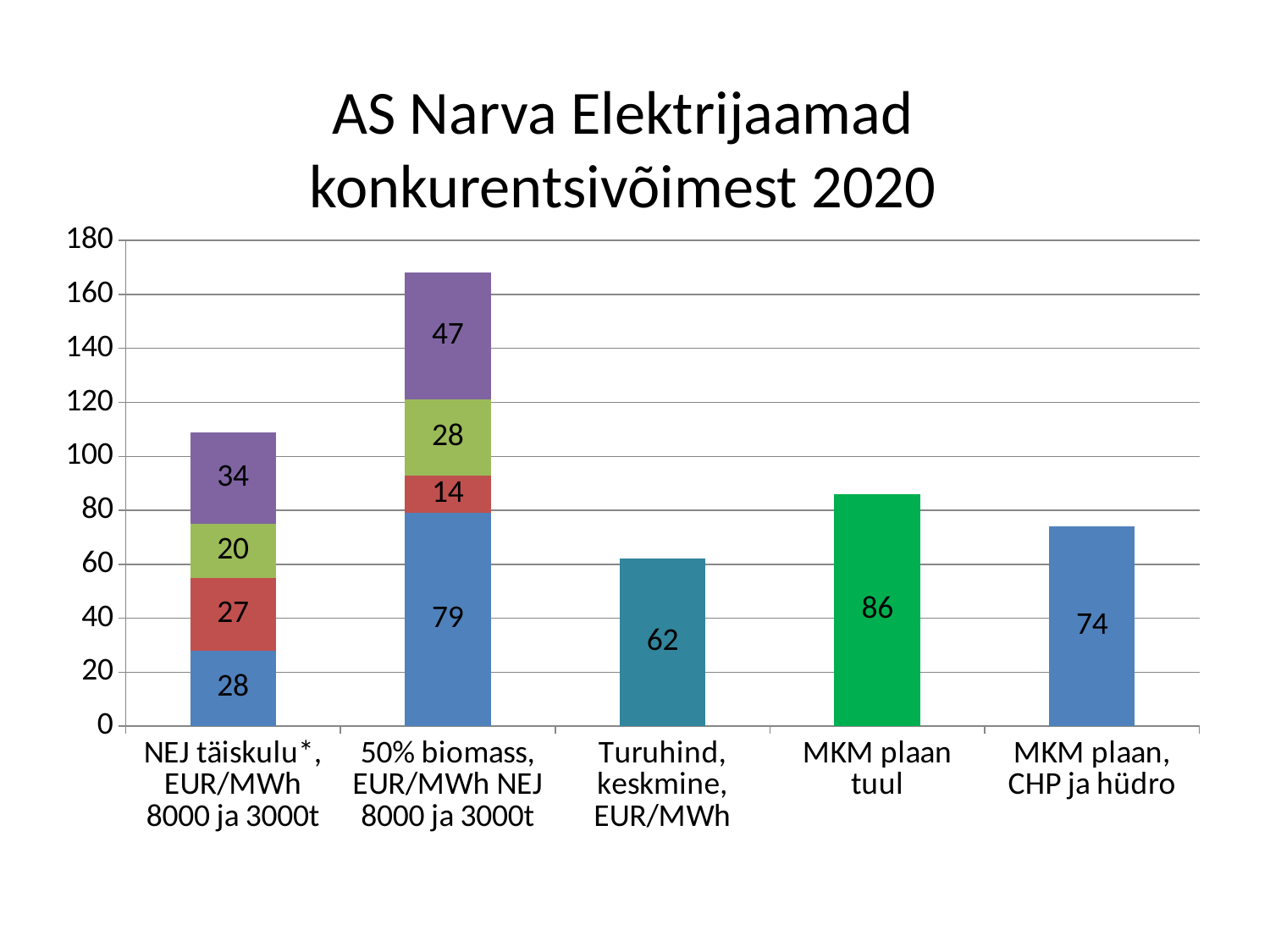
What is the value for "Turuhind, keskmine, EUR/MWh"? 62 What is the total of the stacked bar for "NEJ täiskulu*, EUR/MWh 8000 ja 3000t"? 109 What is the total of the stacked bar for "50% biomass, EUR/MWh NEJ 8000 ja 3000t"? 168 What is the value of the bottom (blue) segment of the "50% biomass, EUR/MWh NEJ 8000 ja 3000t" bar? 79 What is the value for "MKM plaan tuul"? 86 What kind of chart is shown on the slide? Stacked bar chart How many categories are shown on the x axis? 5 Which category has the tallest bar? 50% biomass, EUR/MWh NEJ 8000 ja 3000t What is the value of the top (purple) segment of the "NEJ täiskulu*, EUR/MWh 8000 ja 3000t" bar? 34 What is the value for "MKM plaan, CHP ja hüdro"? 74 What is the title of the chart? AS Narva Elektrijaamad konkurentsivõimest 2020 What is the difference between the values for "MKM plaan tuul" and "Turuhind, keskmine, EUR/MWh"? 24